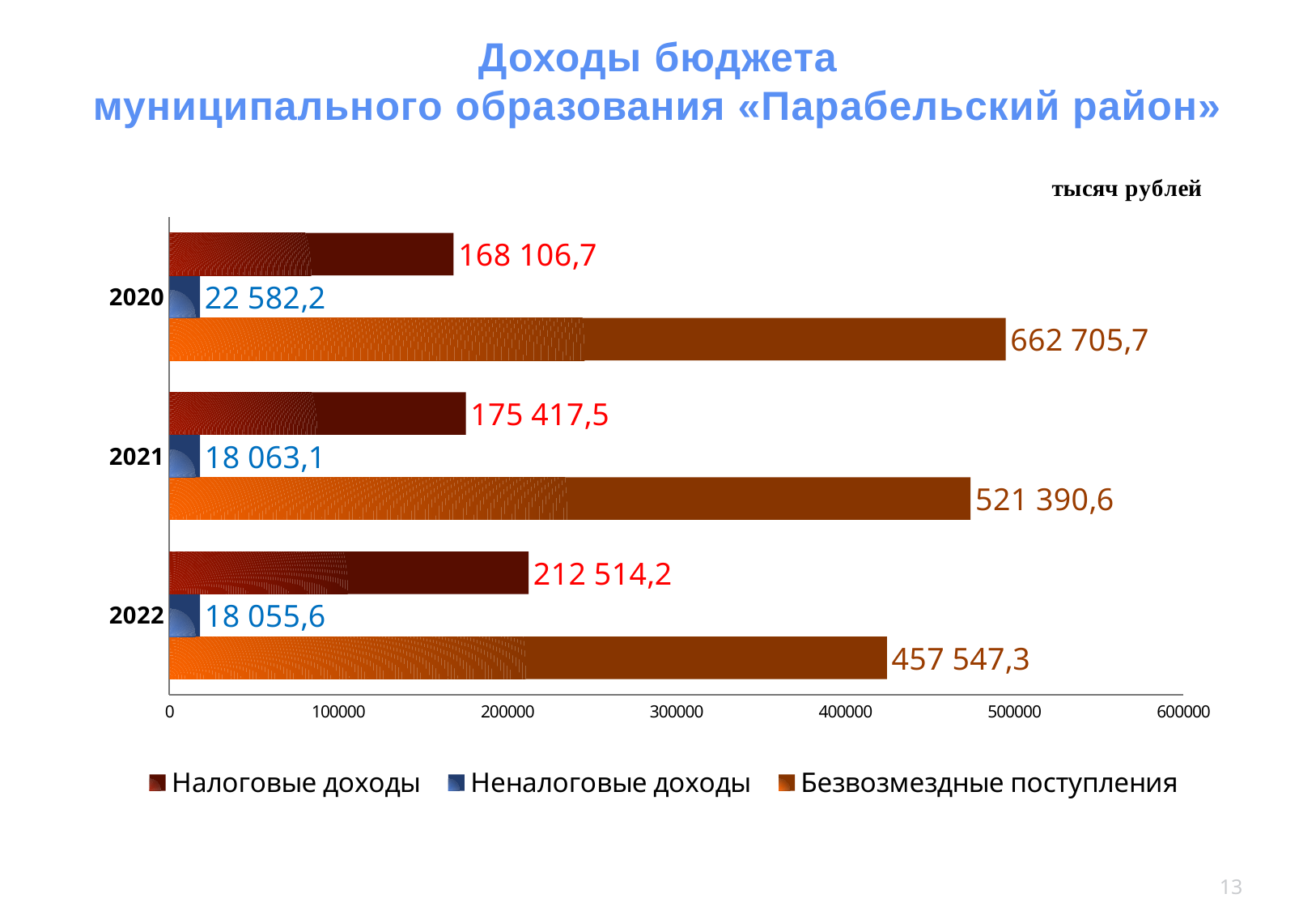
What is the value of Неналоговые доходы for 2021? 18 063,1 What kind of chart is shown on the slide? bar chart Which is larger: Неналоговые доходы in 2020 or in 2022? 2020 In which year is Налоговые доходы the highest? 2022 What is the difference between Налоговые доходы in 2022 and in 2020? 44 407,5 Do the values of Безвозмездные поступления rise or fall from 2020 to 2022? fall What is the value of Налоговые доходы for 2022? 212 514,2 In which year is Безвозмездные поступления the lowest? 2022 What is the difference between Безвозмездные поступления in 2020 and in 2022? 205 158,4 What is the value of Безвозмездные поступления for 2020? 662 705,7 How many series does the legend list? 3